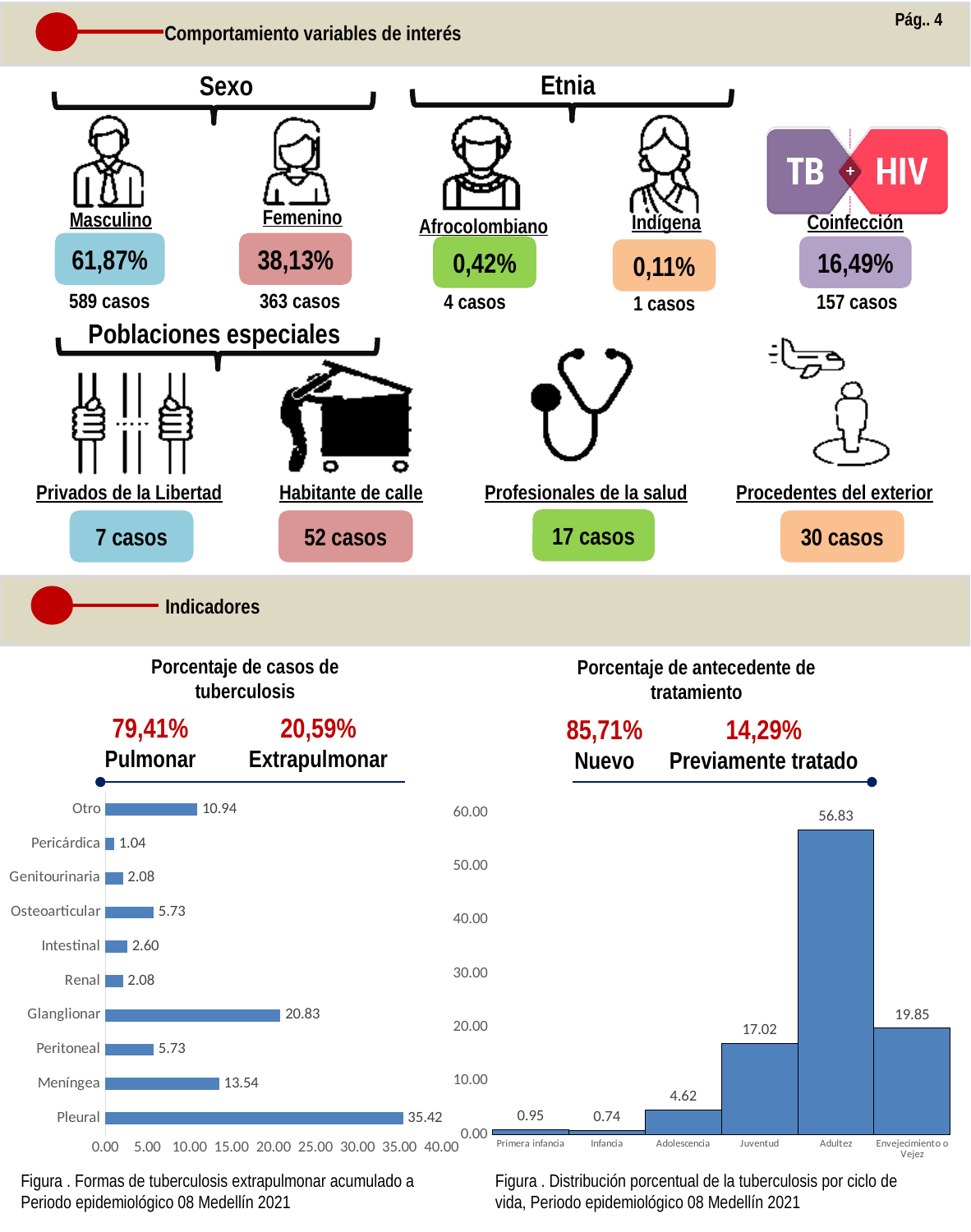
In the right chart (Distribución porcentual por ciclo de vida), what is the value for Adultez? 56.83 In the left chart (Formas de tuberculosis extrapulmonar), what is the value for Pleural? 35.42 In the right chart (Distribución porcentual por ciclo de vida), what is the difference between Adultez and Envejecimiento o Vejez? 36.98 In the right chart (Distribución porcentual por ciclo de vida), what is the value for Juventud? 17.02 In the left chart (Formas de tuberculosis extrapulmonar), which category has the highest value? Pleural In the left chart (Formas de tuberculosis extrapulmonar), which category has the lowest value? Pericárdica In the left chart (Formas de tuberculosis extrapulmonar), what is the difference between Pleural and Meníngea? 21.88 In the left chart (Formas de tuberculosis extrapulmonar), how many categories are shown? 10 In the right chart (Distribución porcentual por ciclo de vida), which is larger, Juventud or Envejecimiento o Vejez? Envejecimiento o Vejez In the left chart (Formas de tuberculosis extrapulmonar), what is the value for Glanglionar? 20.83 What kind of chart is the left chart (Formas de tuberculosis extrapulmonar)? Bar chart In the right chart (Distribución porcentual por ciclo de vida), which category has the lowest value? Infancia